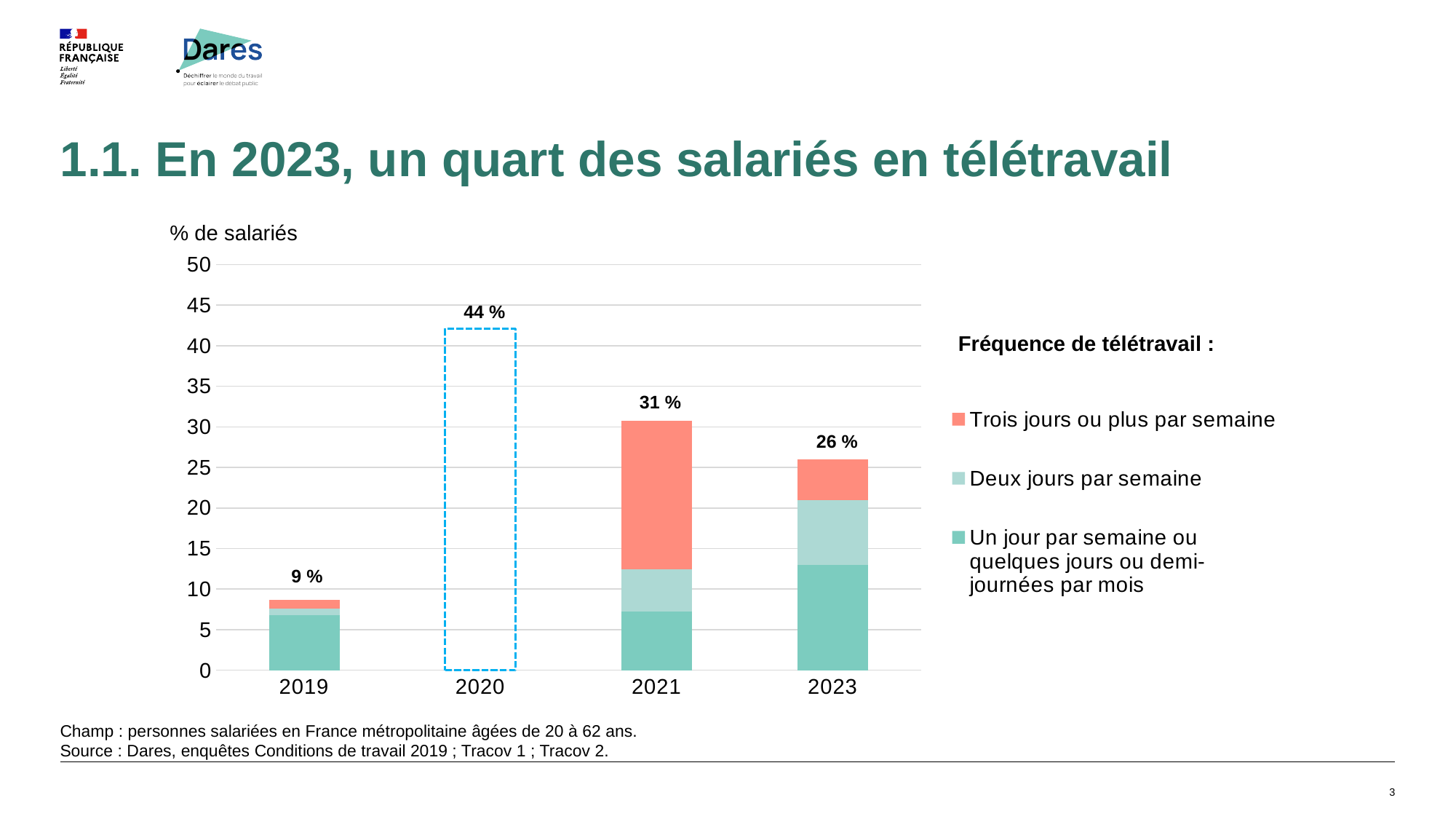
What is the difference in percentage points between the 2021 total and the 2023 total? 5 What is the total share of employees teleworking in 2023? 26 % What is the total value shown for 2020? 44 % Which year has a larger total, 2021 or 2023? 2021 Which year has the highest total share of employees teleworking? 2020 What kind of chart is shown on the slide? stacked bar chart What is the total value shown for 2019? 9 % How many years are shown on the x axis? 4 Do the total values rise or fall from 2020 to 2023? fall Which year has the lowest total share of employees teleworking? 2019 Is the value of the 'Un jour par semaine ou quelques jours ou demi-journées par mois' segment for 2023 greater or less than 10? greater How many series does the legend list? 3